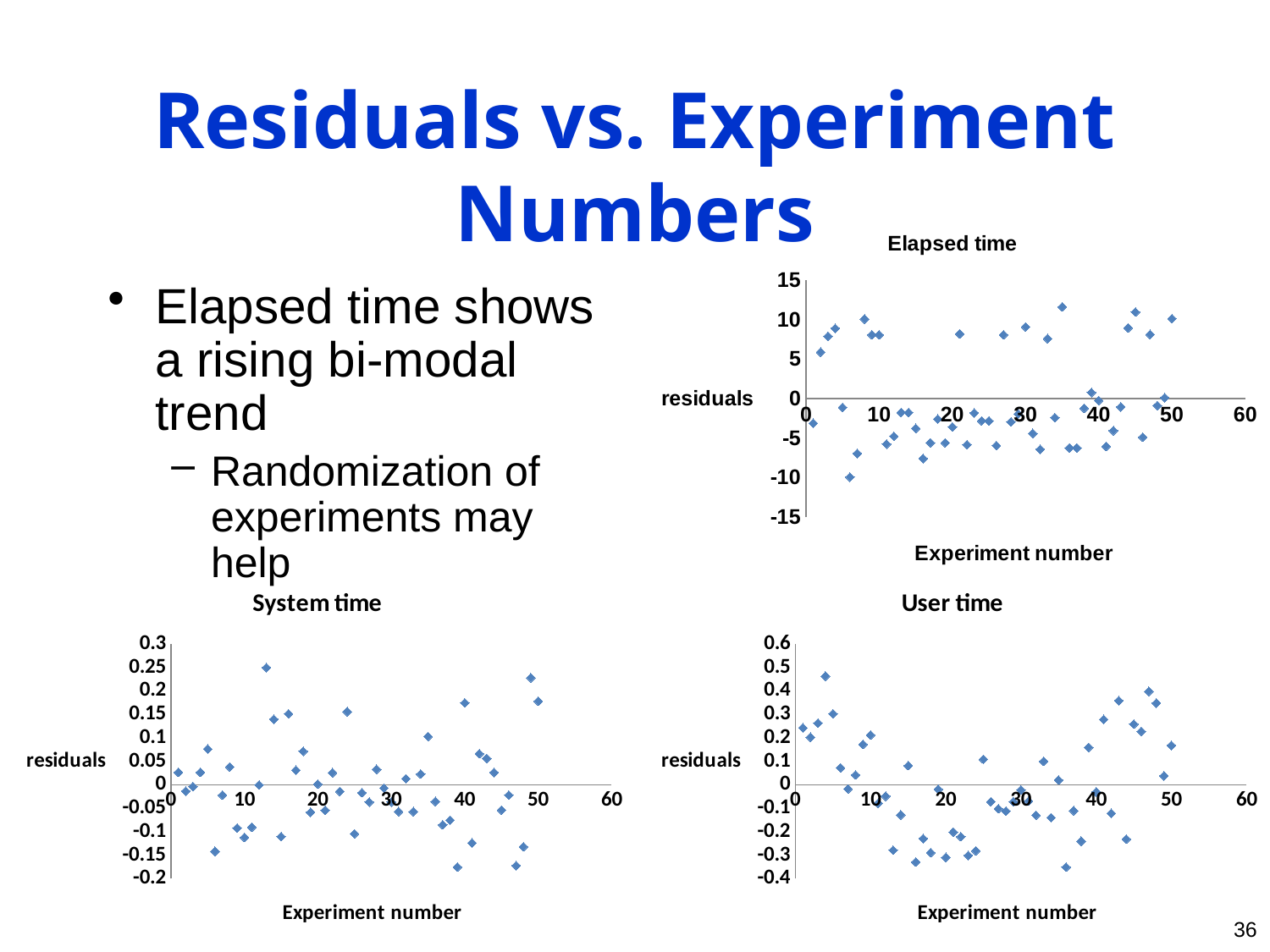
In the 'Elapsed time' chart, is the highest residual greater or less than 10? greater In the 'User time' chart, is the lowest residual greater or less than -0.3? less What is the label on the vertical axis of the 'User time' chart? residuals What kind of chart is the 'Elapsed time' chart? scatter chart In the 'User time' chart, is the highest residual greater or less than 0.4? greater How many charts are shown on the slide? 3 What kind of chart is the 'System time' chart? scatter chart What kind of chart is the 'User time' chart? scatter chart